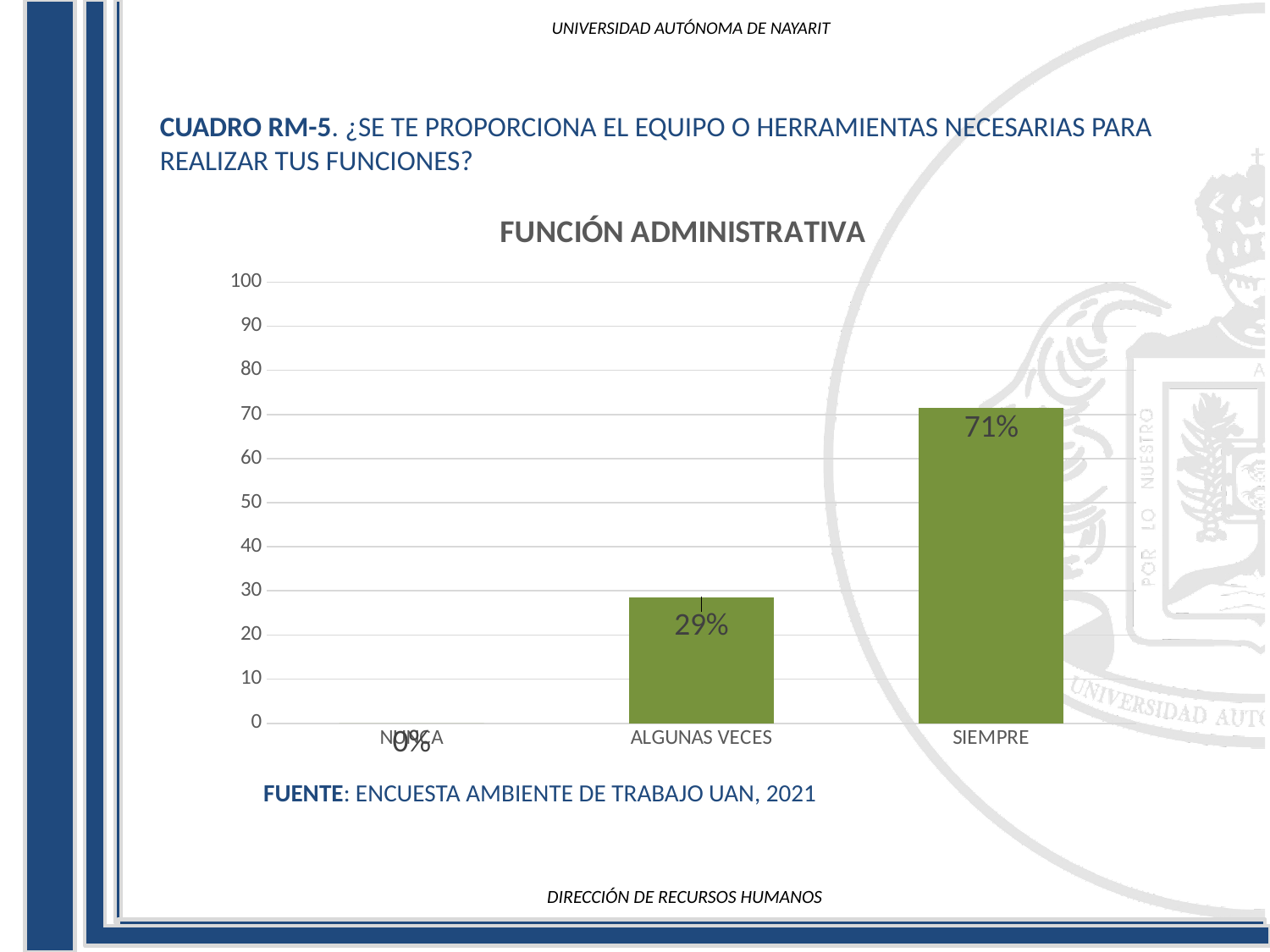
What is the title of the chart? FUNCIÓN ADMINISTRATIVA Which category has the lowest value? NUNCA Which category has the highest value? SIEMPRE What is the value for ALGUNAS VECES? 29% Is the value for ALGUNAS VECES greater or less than 40? less What is the value for NUNCA? 0% Which is larger, the value for ALGUNAS VECES or the value for SIEMPRE? SIEMPRE What kind of chart is shown? bar chart Is the value for SIEMPRE greater or less than 60? greater What is the difference between the values for SIEMPRE and ALGUNAS VECES? 42% What is the value for SIEMPRE? 71% How many categories are shown on the x axis? 3